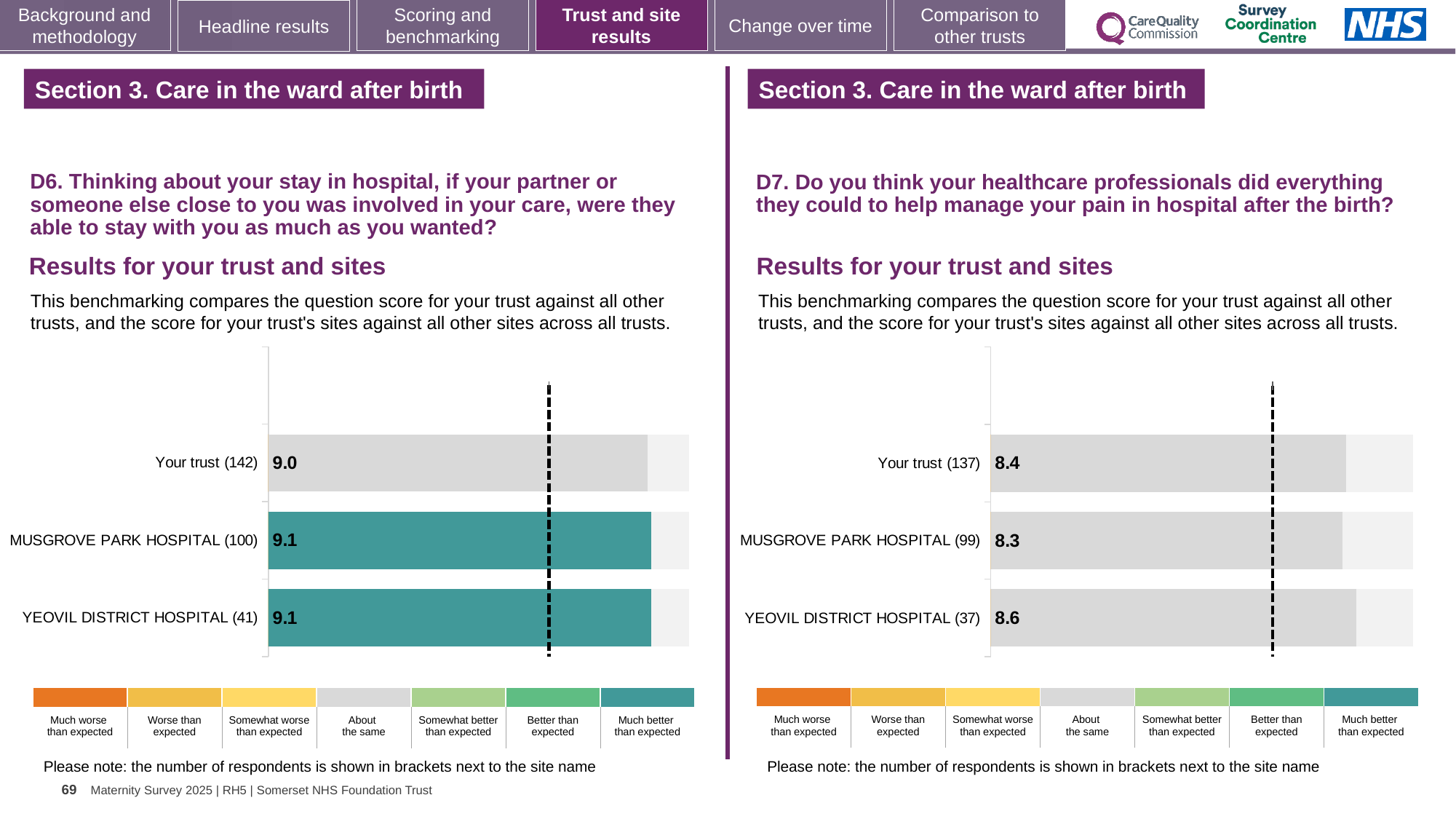
In the D7 chart on the right, what is the score for YEOVIL DISTRICT HOSPITAL? 8.6 In the D7 chart on the right, which has the larger score, Your trust or MUSGROVE PARK HOSPITAL? Your trust In the D6 chart on the left, what is the score for Your trust? 9.0 In the D7 chart on the right, which site or trust has the lowest score? MUSGROVE PARK HOSPITAL In the D7 chart on the right, what is the difference between the scores for YEOVIL DISTRICT HOSPITAL and MUSGROVE PARK HOSPITAL? 0.3 In the D6 chart on the left, what is the score for MUSGROVE PARK HOSPITAL? 9.1 In the D6 chart on the left, which site or trust has the lowest score? Your trust What kind of chart is used for the D7 results on the right? Bar chart How many bars are plotted in the D6 chart on the left? 3 In the D6 chart on the left, what is the difference between the scores for YEOVIL DISTRICT HOSPITAL and Your trust? 0.1 In the D7 chart on the right, which site or trust has the highest score? YEOVIL DISTRICT HOSPITAL In the D7 chart on the right, what is the score for Your trust? 8.4